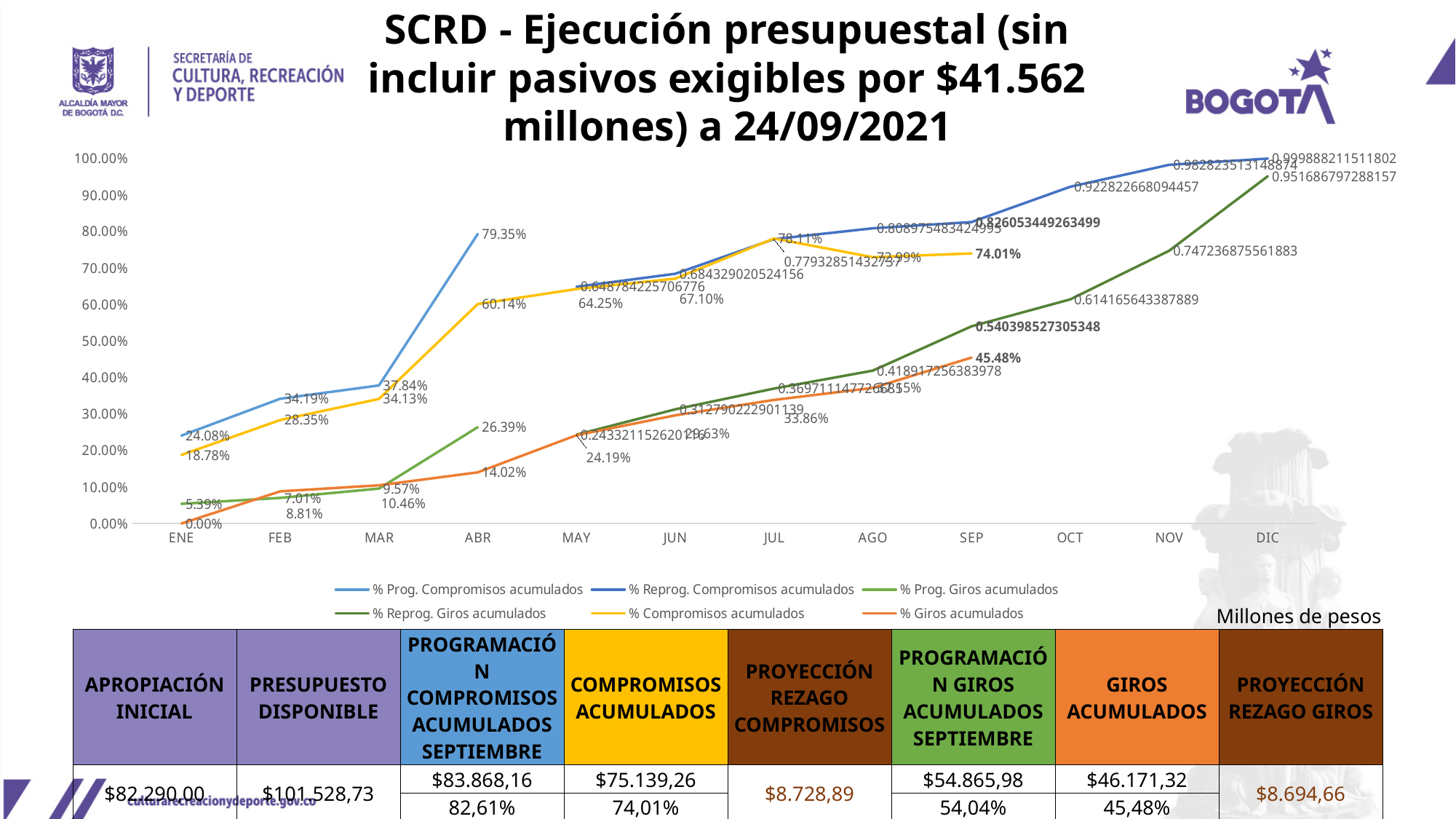
How many series does the chart legend list? 6 What is the value of % Prog. Giros acumulados in ABR? 26.39% What is the value of % Prog. Compromisos acumulados in ABR? 79.35% In which month does % Compromisos acumulados reach its highest value? JUL By how many percentage points does % Compromisos acumulados increase from MAR to ABR? 26.01 How many months are shown along the x axis of the chart? 12 What is the value of % Compromisos acumulados in SEP? 74.01% What kind of chart is shown on the slide? Line chart In ABR, which is larger: % Prog. Compromisos acumulados or % Compromisos acumulados? % Prog. Compromisos acumulados What is the value of % Giros acumulados in SEP? 45.48% Is the value of % Reprog. Giros acumulados in DIC greater or less than 90.00%? greater What is the value of % Giros acumulados in ENE? 0.00%